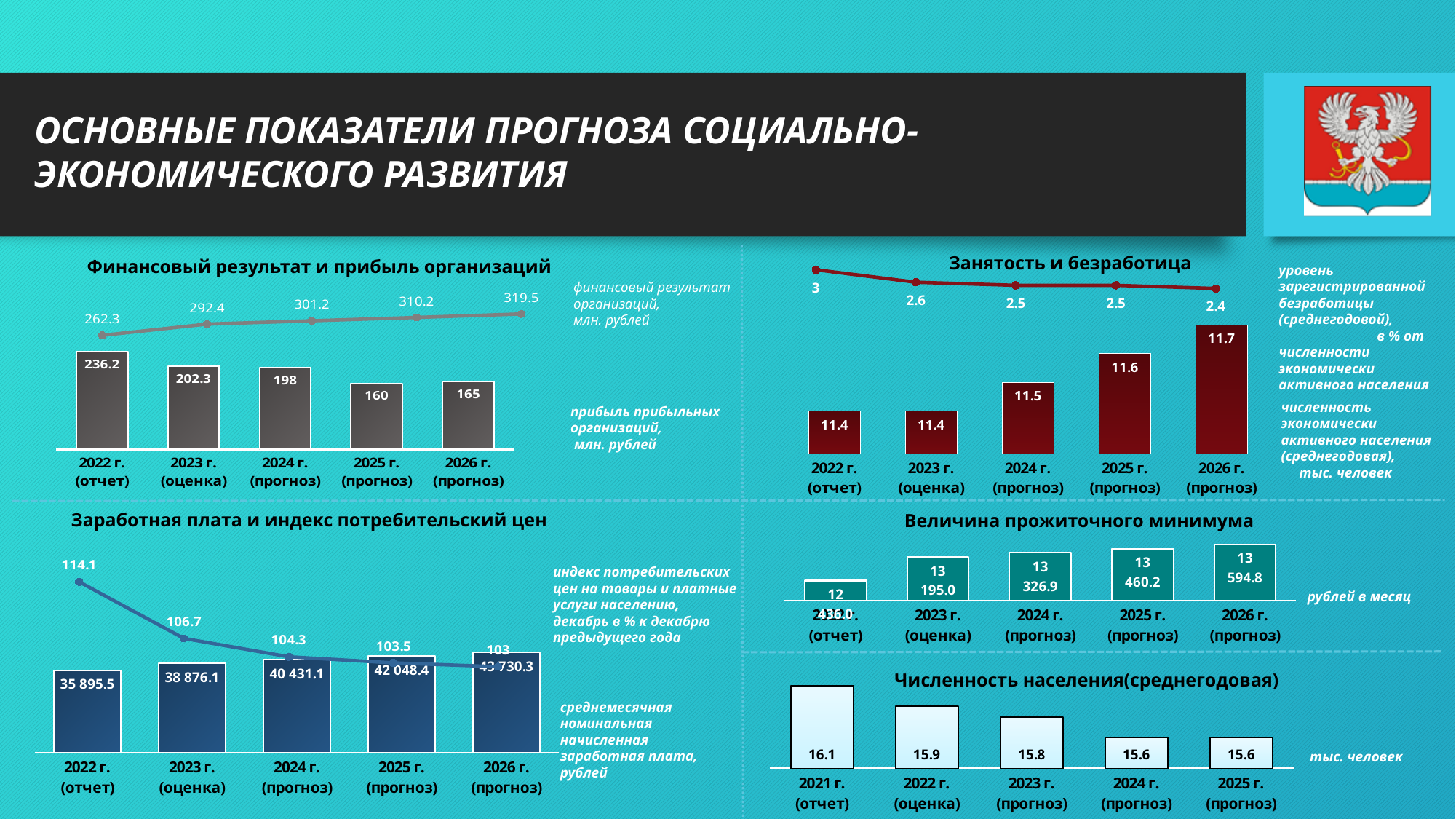
In the chart 'Занятость и безработица', does the unemployment rate line rise or fall from 2022 to 2026? fall In the chart 'Численность населения(среднегодовая)', how many years are shown on the x axis? 5 In the chart 'Финансовый результат и прибыль организаций', which year has the lowest profit bar? 2025 г. (прогноз) In the chart 'Заработная плата и индекс потребительский цен', what is the consumer price index for 2022 г. (отчет)? 114.1 In the chart 'Занятость и безработица', what is the economically active population for 2026 г. (прогноз)? 11.7 In the chart 'Величина прожиточного минимума', what is the value for 2026 г. (прогноз)? 13 594.8 In the chart 'Финансовый результат и прибыль организаций', what is the financial result (line) for 2026 г. (прогноз)? 319.5 In the chart 'Финансовый результат и прибыль организаций', what is the profit of profitable organisations (bar) for 2022 г. (отчет)? 236.2 In the chart 'Численность населения(среднегодовая)', which year has the highest value? 2021 г. (отчет) In the chart 'Занятость и безработица', what is the registered unemployment rate for 2022 г. (отчет)? 3 In the chart 'Финансовый результат и прибыль организаций', what is the difference between the financial result for 2023 г. and 2022 г.? 30.1 In the chart 'Заработная плата и индекс потребительский цен', what is the average monthly wage for 2025 г. (прогноз)? 42 048.4